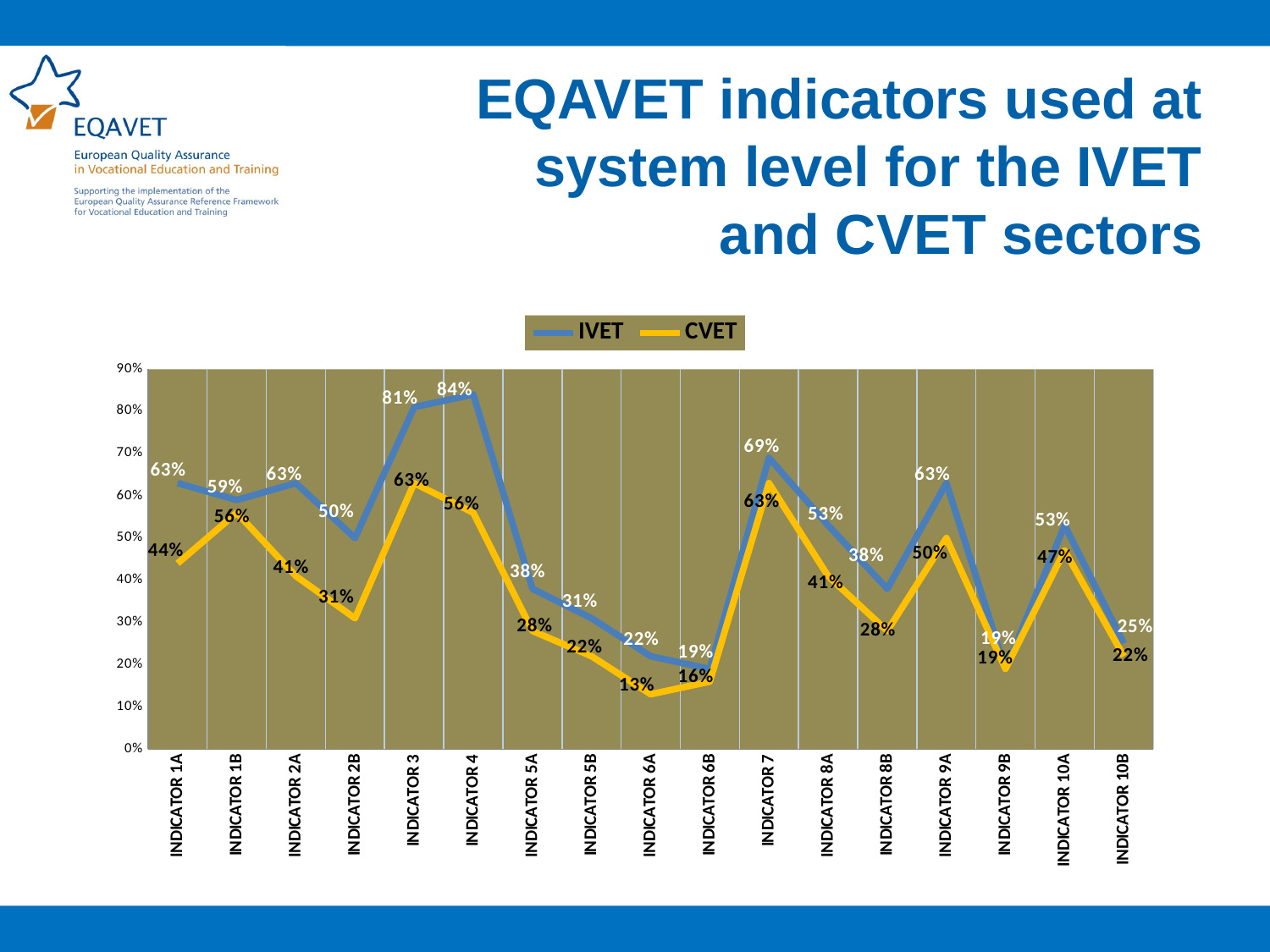
What is the difference between the IVET values for INDICATOR 3 and INDICATOR 5A? 43 percentage points Which indicator has the highest IVET value? INDICATOR 4 What is the difference between the IVET and CVET values for INDICATOR 4? 28 percentage points Which indicator has the lowest CVET value? INDICATOR 6A What colour is the CVET line in the legend? Yellow How many series does the legend list? 2 For INDICATOR 7, which series has the larger value, IVET or CVET? IVET What is the CVET value for INDICATOR 9A? 50% What is the IVET value for INDICATOR 3? 81% How many indicators are shown on the x axis? 17 What is the CVET value for INDICATOR 6A? 13% What kind of chart is shown on the slide? Line chart